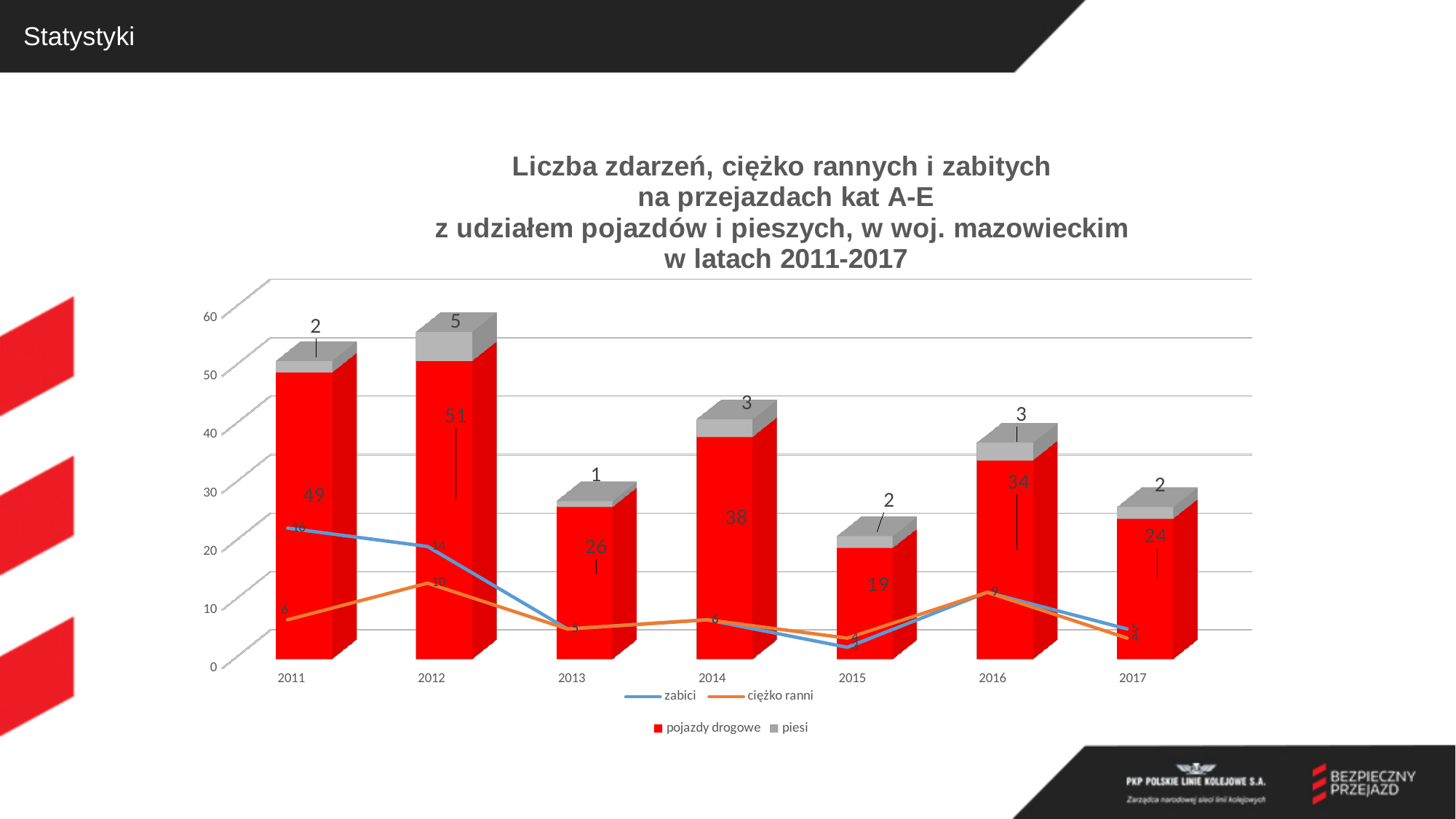
Which year has the lowest value for piesi? 2013 How many series does the legend list? 4 Which series is shown in red in the stacked bars? pojazdy drogowe How many years are shown on the x axis? 7 What is the total of the stacked bar for 2012? 56 What is the difference between the pojazdy drogowe values for 2014 and 2017? 14 What is the value for piesi in 2014? 3 Which is larger, the pojazdy drogowe value for 2016 or for 2013? 2016 What is the value for pojazdy drogowe in 2012? 51 What is the value for pojazdy drogowe in 2015? 19 Which year has the highest value for pojazdy drogowe? 2012 What is the total of the stacked bar for 2015? 21